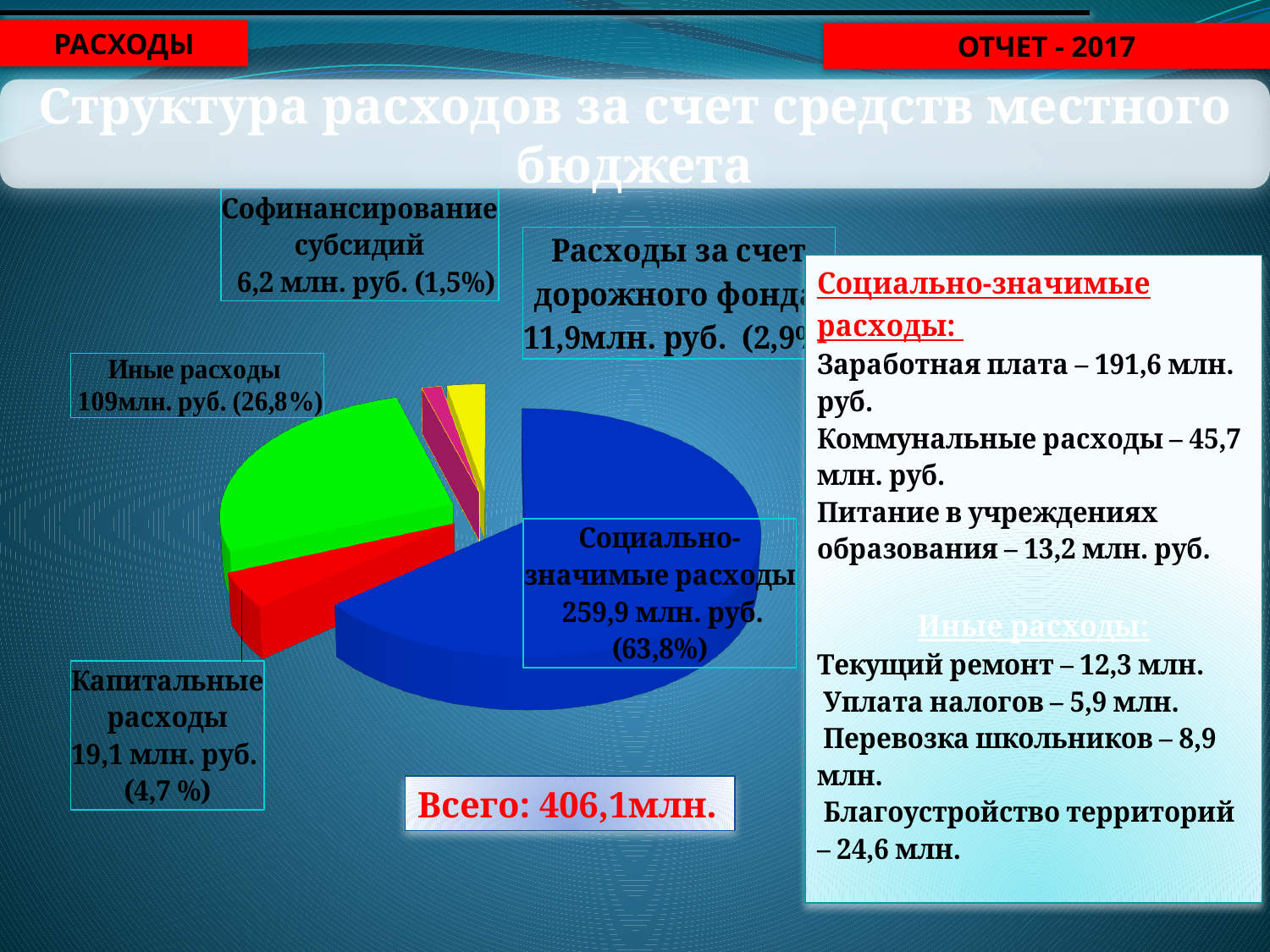
How many slices does the pie chart have? 5 What is the value for Капитальные расходы? 19,1 млн. руб. Which category has the largest slice of the pie? Социально-значимые расходы What share of the pie does Иные расходы represent? 26,8% What share of the pie does Капитальные расходы represent? 4,7 % What is the value for Иные расходы? 109 млн. руб. Which is larger, Капитальные расходы or Расходы за счет дорожного фонда? Капитальные расходы What is the difference between Социально-значимые расходы and Иные расходы? 150,9 млн. руб. Which category has the smallest slice of the pie? Софинансирование субсидий What kind of chart is shown on the slide? pie chart What is the value for Софинансирование субсидий? 6,2 млн. руб. What is the value for Социально-значимые расходы? 259,9 млн. руб.